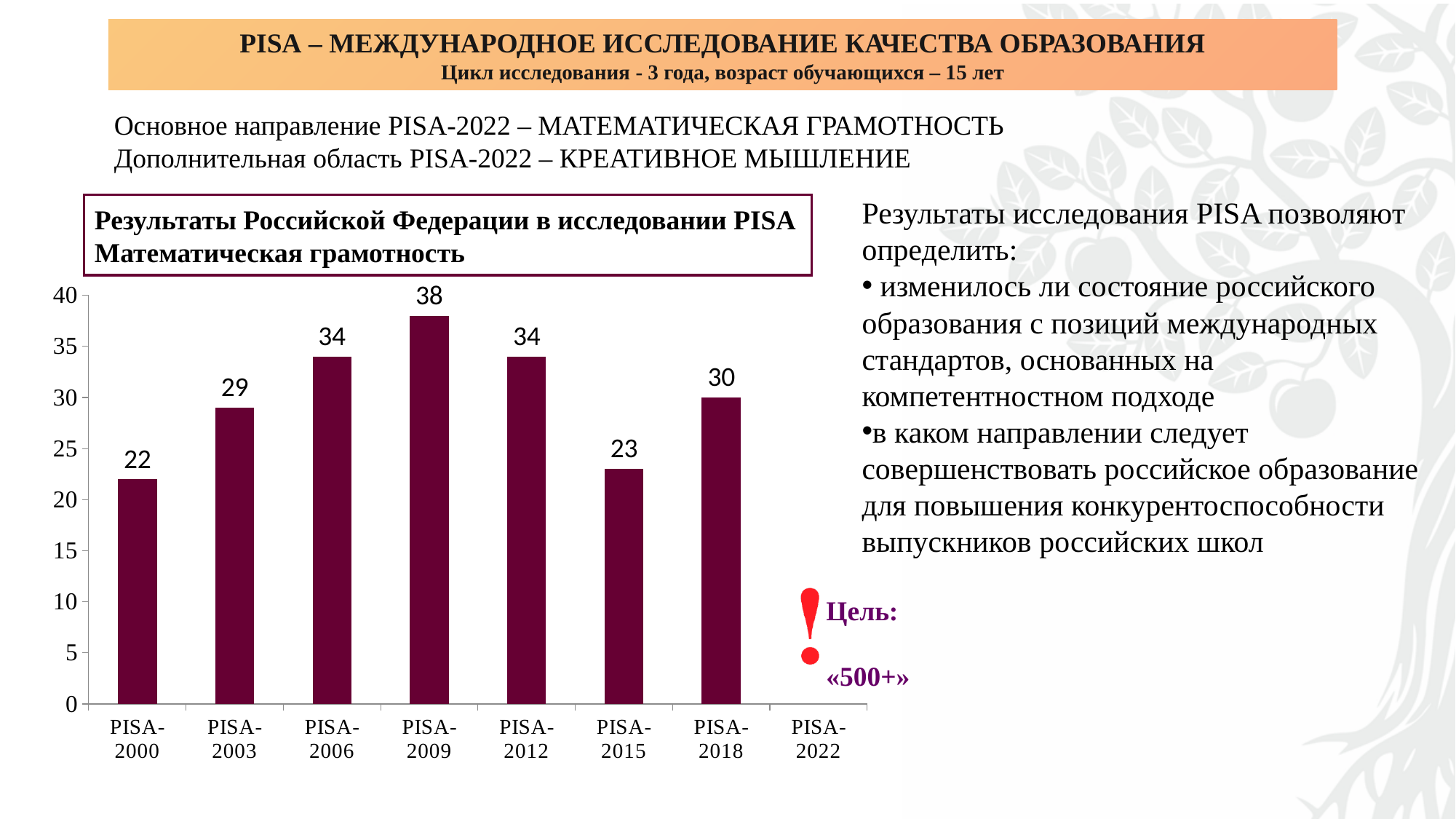
How many bars are plotted in the chart? 7 Which is larger, the value for PISA-2003 or the value for PISA-2018? PISA-2018 Do the values rise or fall from PISA-2000 to PISA-2009? rise What is the value for PISA-2000? 22 What is the difference between the values for PISA-2009 and PISA-2000? 16 What type of chart is shown on the slide? bar chart What is the value for PISA-2018? 30 Which PISA cycle has the lowest value? PISA-2000 Which PISA cycle has the highest value? PISA-2009 What is the difference between the values for PISA-2018 and PISA-2015? 7 Is the value for PISA-2015 greater or less than 25? less What is the value for PISA-2015? 23